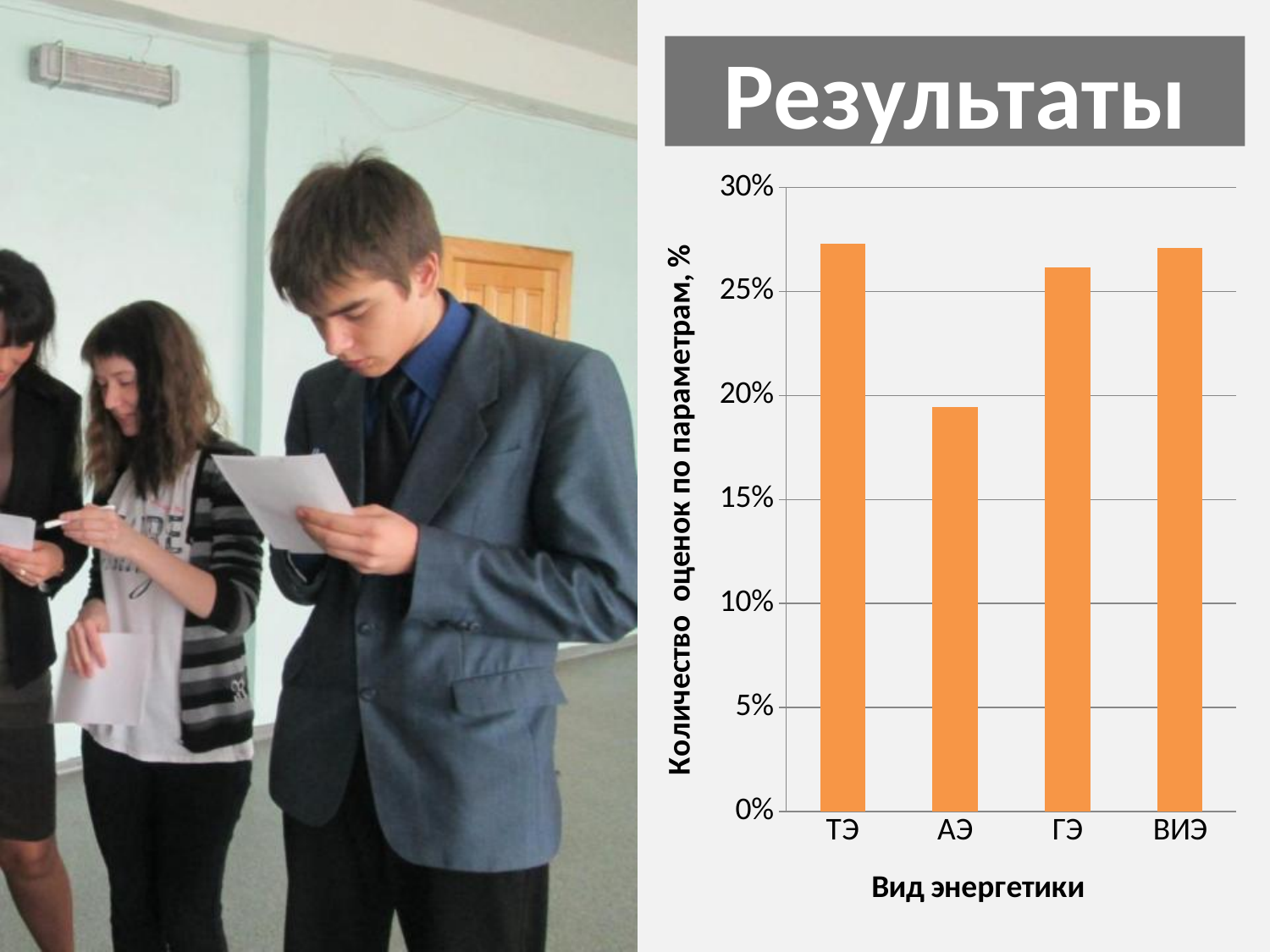
What is the title of the chart? Результаты Is the value for АЭ greater or less than 20%? less How many categories are shown on the x axis of the chart? 4 Which category has the lowest value in the chart? АЭ Is the value for ТЭ greater or less than 25%? greater Which is larger, the value for АЭ or the value for ГЭ? ГЭ Is the value for АЭ greater or less than 15%? greater Which is larger, the value for ТЭ or the value for АЭ? ТЭ What kind of chart is shown on the slide? bar chart What is the label of the x axis of the chart? Вид энергетики